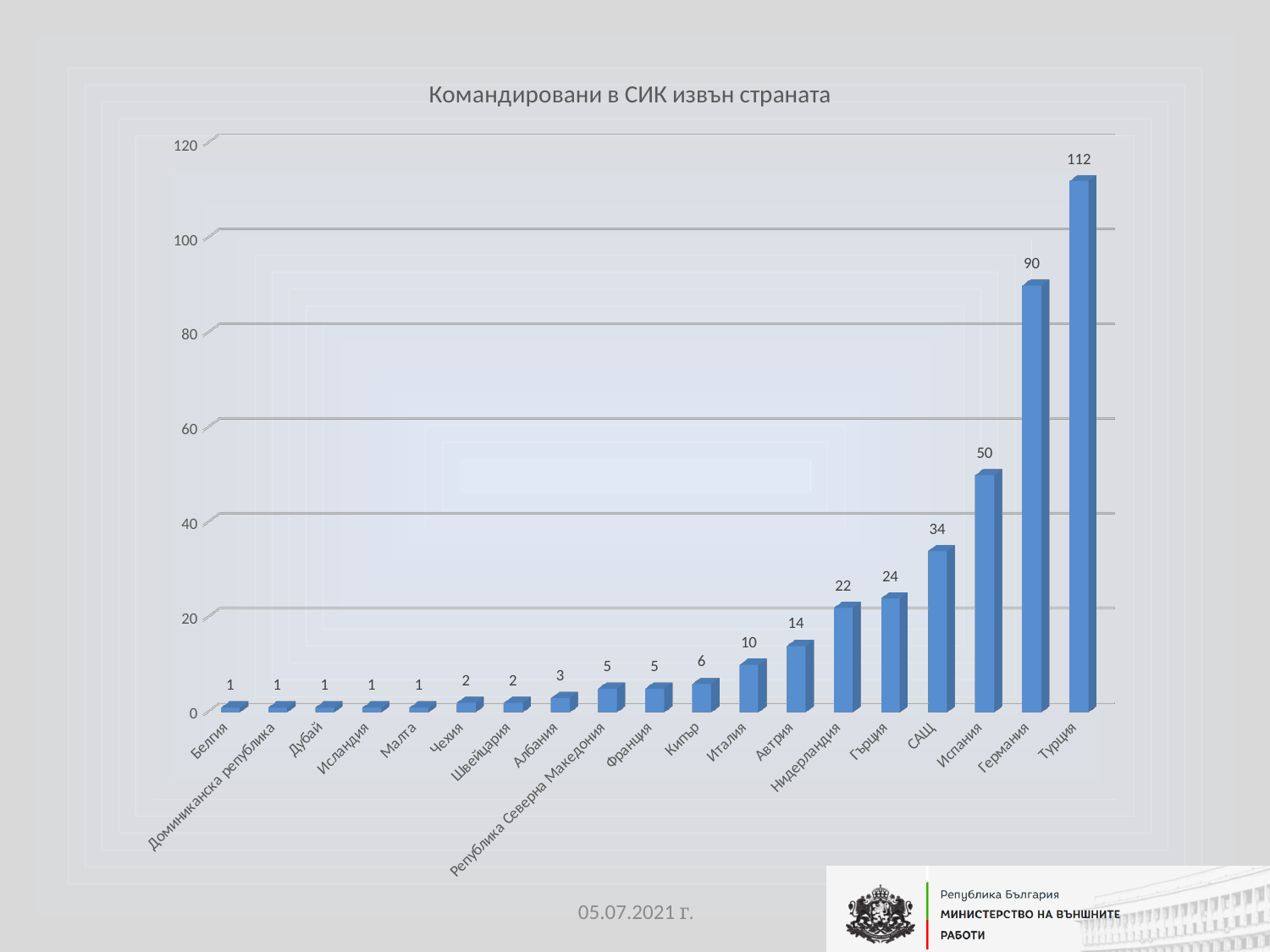
Which is larger, the value for Гърция or the value for Австрия? Гърция How many categories are shown on the x axis? 19 What is the difference between the values for Турция and Германия? 22 What is the value for Нидерландия? 22 Which category has the highest value? Турция What is the difference between the values for Испания and САЩ? 16 Is the value for Германия greater or less than 80? greater What is the value for Турция? 112 What is the title of the chart? Командировани в СИК извън страната What is the value for Германия? 90 What is the value for Кипър? 6 What kind of chart is shown on the slide? bar chart